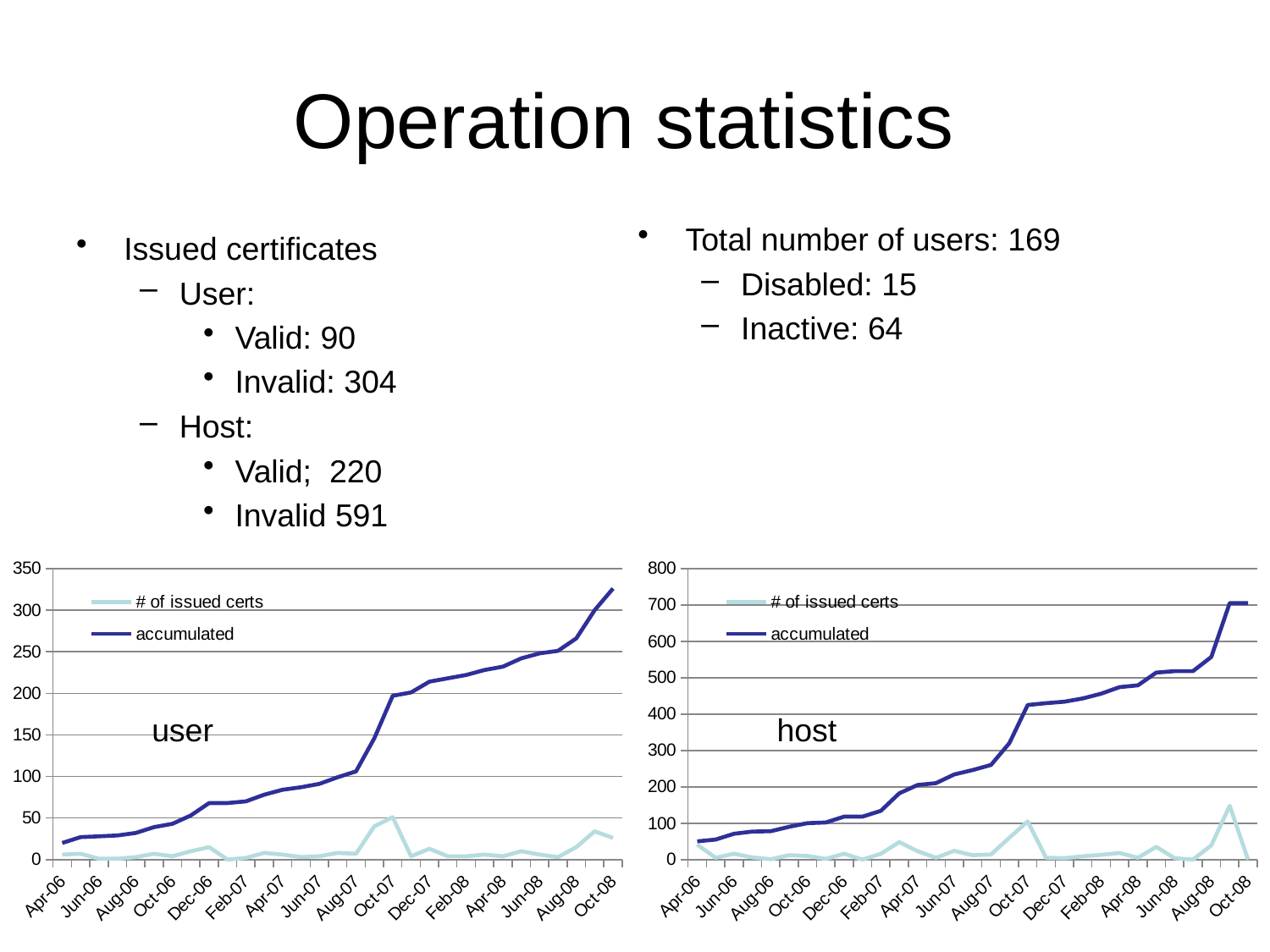
In the "user" chart, which series is higher at Oct-08, # of issued certs or accumulated? accumulated What is the first x-axis label on the "host" chart? Apr-06 In the "user" chart, how many series does the legend list? 2 In the "user" chart, is the accumulated value at Apr-06 greater or less than 50? less In the "host" chart, is the accumulated value at Dec-07 greater or less than 400? greater In the "host" chart, does the accumulated series rise or fall over time? rise What kind of chart is the chart labelled "host"? line chart In the "user" chart, does the accumulated series rise or fall from Apr-06 to Oct-08? rise In the "host" chart, what are the two series named in the legend? # of issued certs, accumulated In the "user" chart, is the accumulated value at Oct-08 greater or less than 300? greater What kind of chart is the chart labelled "user"? line chart